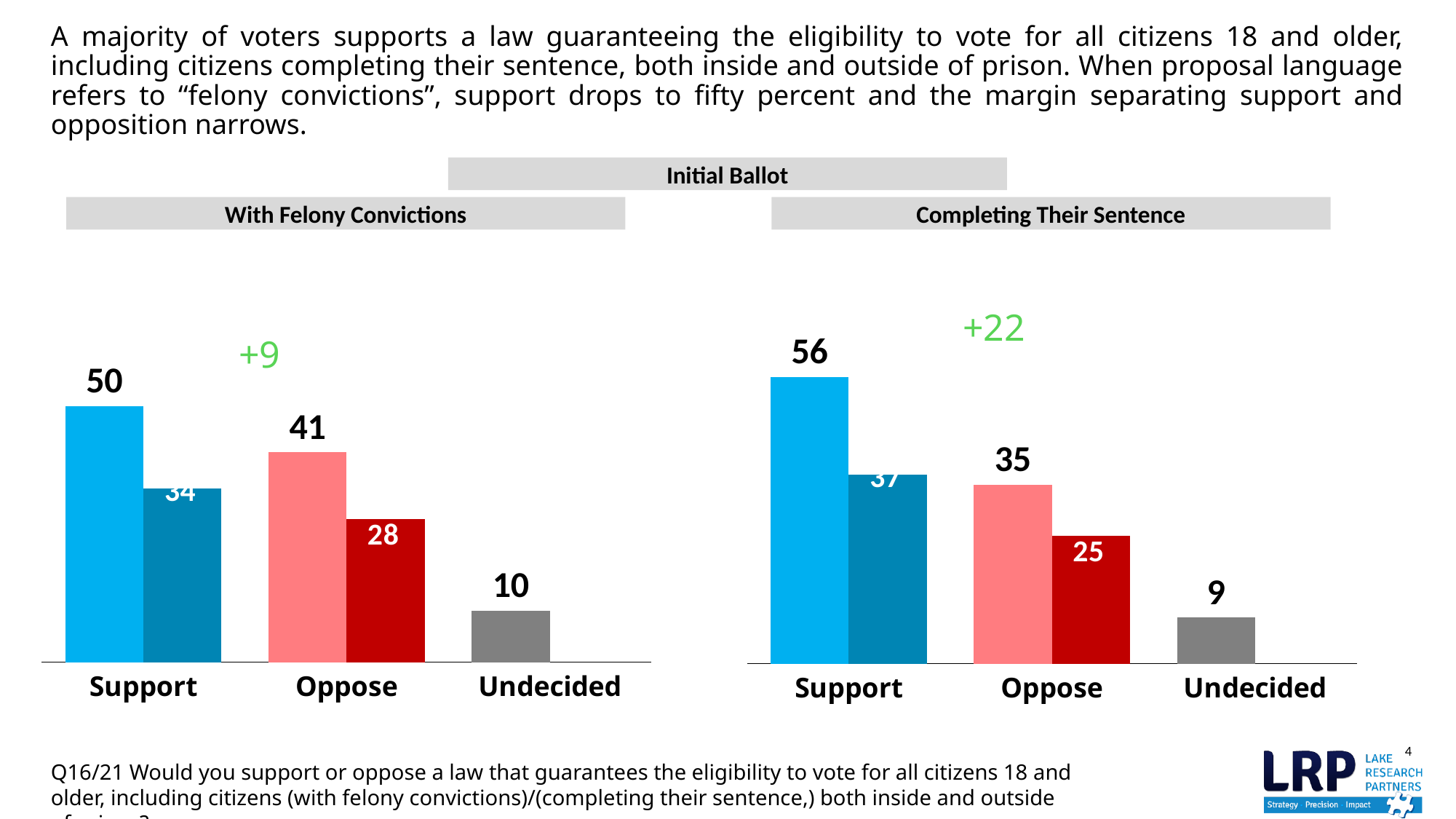
In the "With Felony Convictions" chart, what is the value of the tallest Oppose bar? 41 In the "Completing Their Sentence" chart, which category has the lowest value? Undecided In the "Completing Their Sentence" chart, what is the value of the tallest Support bar? 56 In the "With Felony Convictions" chart, which is larger: the dark blue Support bar or the dark red Oppose bar? the dark blue Support bar In the "With Felony Convictions" chart, what is the value of the tallest Support bar? 50 What kind of chart is used for the "Completing Their Sentence" data? bar chart In the "With Felony Convictions" chart, what is the difference between the tallest Support bar and the tallest Oppose bar? 9 How many categories are shown on the x axis of the "With Felony Convictions" chart? 3 In the "Completing Their Sentence" chart, what is the difference between the tallest Support bar and the tallest Oppose bar? 21 In the "Completing Their Sentence" chart, what is the value of the dark red Oppose bar? 25 In the "With Felony Convictions" chart, what is the value for Undecided? 10 In the "Completing Their Sentence" chart, what is the value for Undecided? 9